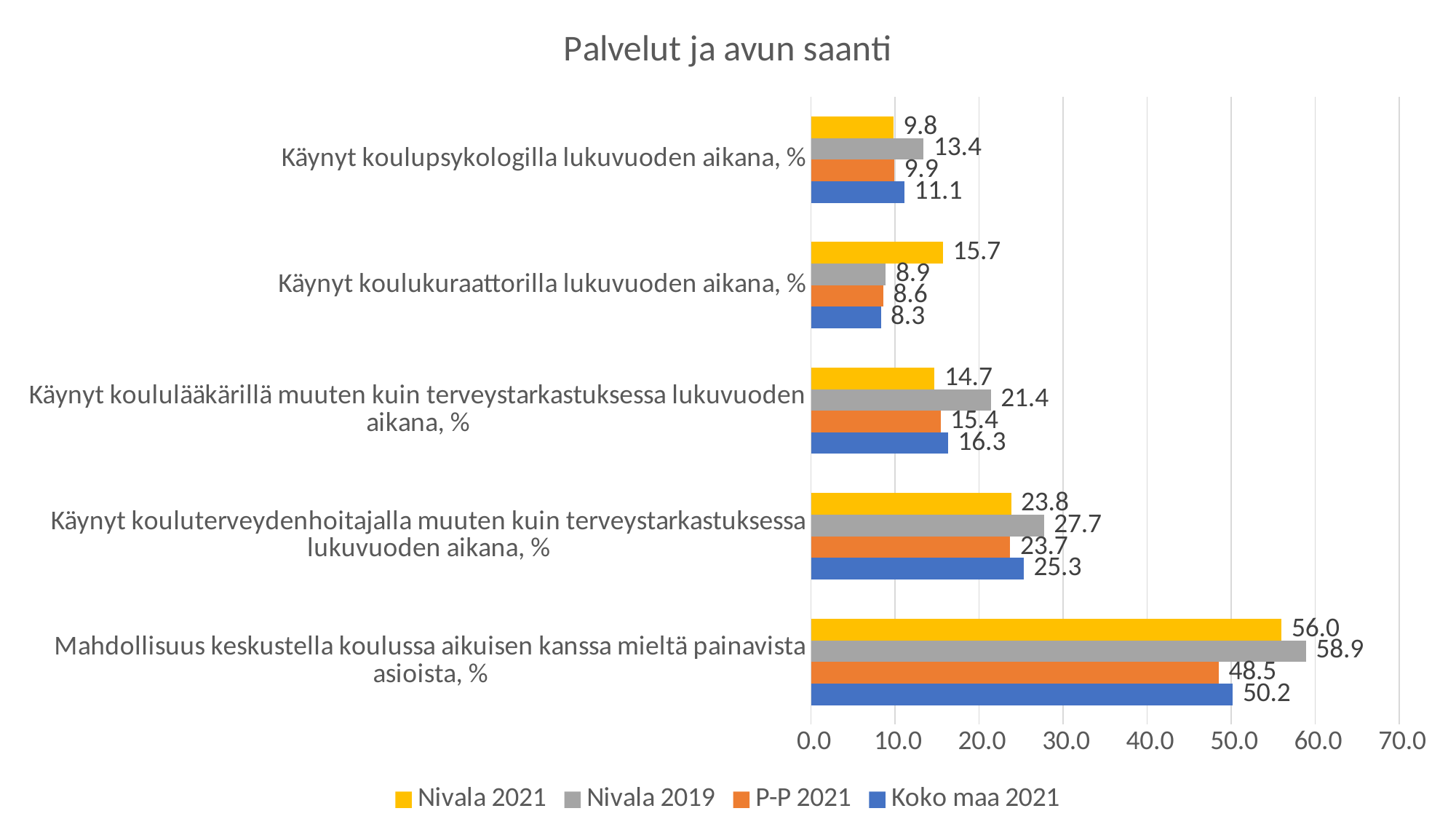
What is the Nivala 2019 value for "Mahdollisuus keskustella koulussa aikuisen kanssa mieltä painavista asioista, %"? 58.9 What is the Nivala 2021 value for "Käynyt koulukuraattorilla lukuvuoden aikana, %"? 15.7 How many categories are shown on the chart? 5 Which series has the lowest value for "Käynyt koulukuraattorilla lukuvuoden aikana, %"? Koko maa 2021 What is the Koko maa 2021 value for "Käynyt koulupsykologilla lukuvuoden aikana, %"? 11.1 What is the P-P 2021 value for "Käynyt koululääkärillä muuten kuin terveystarkastuksessa lukuvuoden aikana, %"? 15.4 How many series does the legend list? 4 Which series has the highest value for "Käynyt kouluterveydenhoitajalla muuten kuin terveystarkastuksessa lukuvuoden aikana, %"? Nivala 2019 For "Mahdollisuus keskustella koulussa aikuisen kanssa mieltä painavista asioista, %", which is larger: the P-P 2021 value or the Koko maa 2021 value? Koko maa 2021 Is the Nivala 2021 value for "Mahdollisuus keskustella koulussa aikuisen kanssa mieltä painavista asioista, %" greater or less than 50.0? greater What kind of chart is shown on the slide? Bar chart What is the difference between the Nivala 2019 and Nivala 2021 values for "Käynyt koululääkärillä muuten kuin terveystarkastuksessa lukuvuoden aikana, %"? 6.7